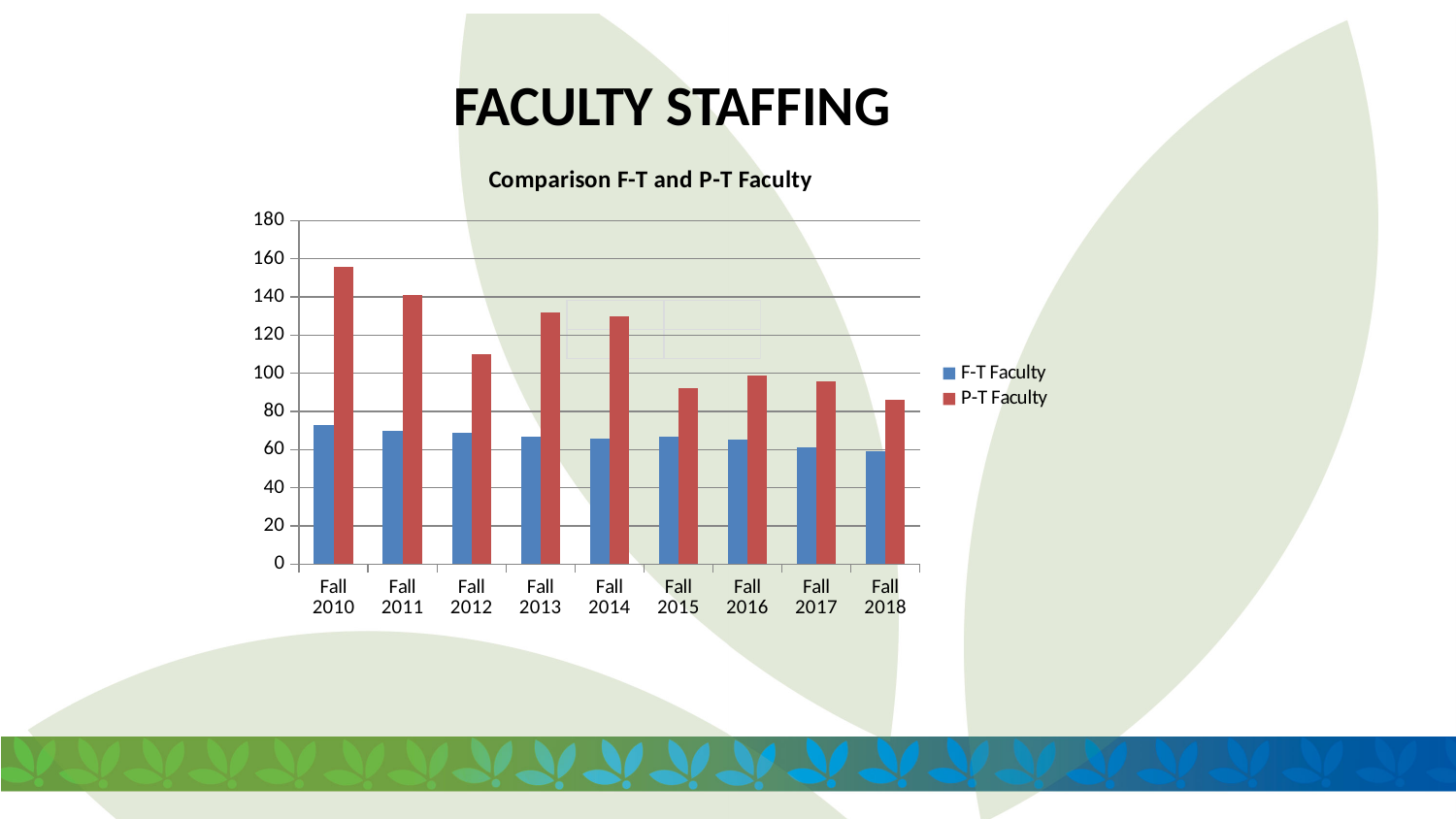
Which is larger, the P-T Faculty value for Fall 2012 or for Fall 2013? Fall 2013 How many series does the legend list? 2 Is the F-T Faculty value for Fall 2010 greater or less than 80? less In which Fall term is the P-T Faculty value highest? Fall 2010 Is the P-T Faculty value for Fall 2015 greater or less than 100? less Is the P-T Faculty value for Fall 2010 greater or less than 140? greater In which Fall term is the P-T Faculty value lowest? Fall 2018 What is the title of the chart? Comparison F-T and P-T Faculty What type of chart is shown on the slide? Bar chart In Fall 2018, which series has the larger value, F-T Faculty or P-T Faculty? P-T Faculty Do the P-T Faculty values generally rise or fall from Fall 2010 to Fall 2018? fall How many Fall terms are shown on the x axis? 9